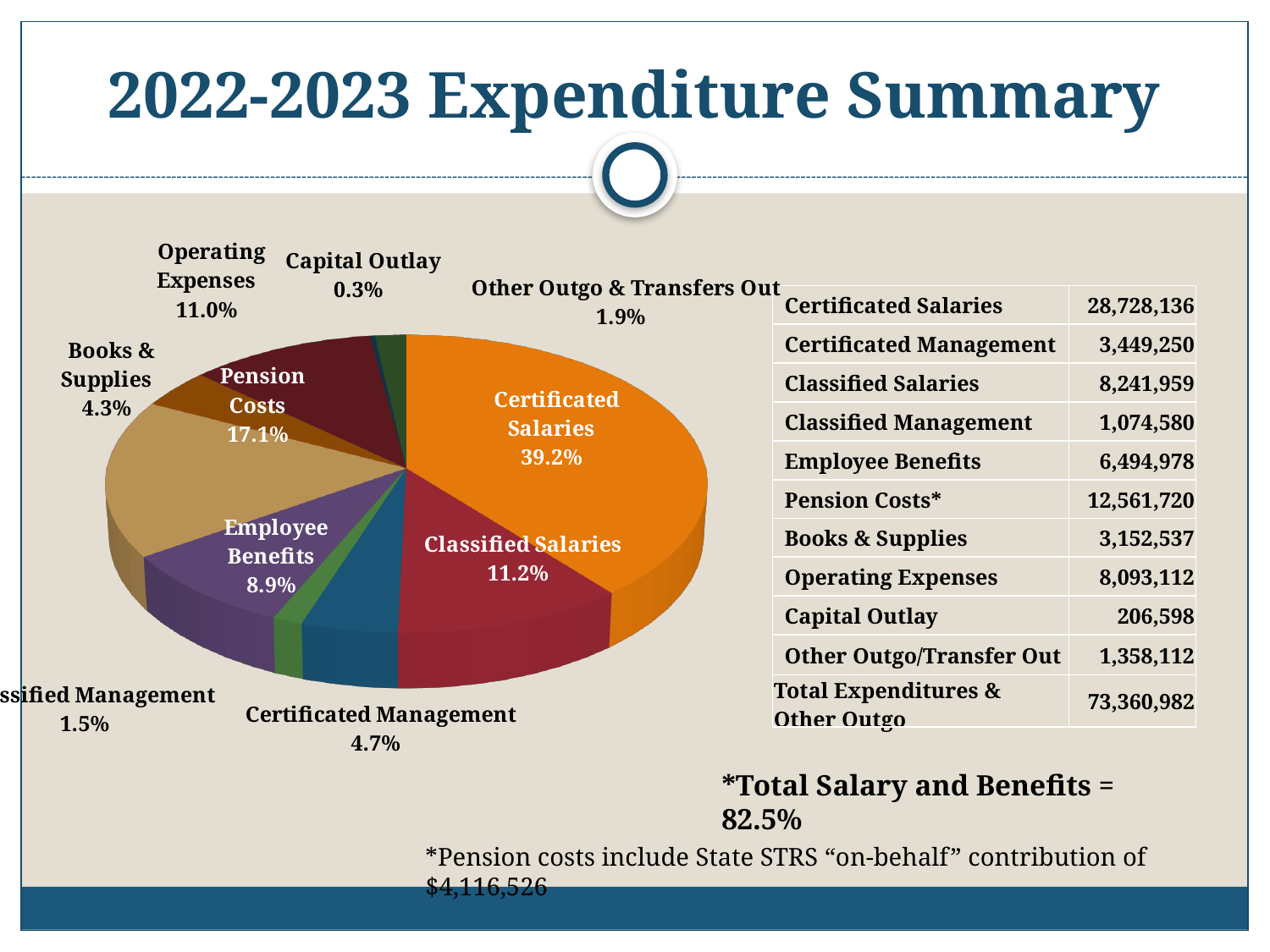
What percentage is shown for Employee Benefits in the pie chart? 8.9% What kind of chart is shown on the slide? pie chart How many percentage points larger is the Certificated Salaries share than the Pension Costs share? 22.1 percentage points Which slice is larger, Classified Salaries or Certificated Management? Classified Salaries Which category has the largest slice of the pie chart? Certificated Salaries Which category has the smallest slice of the pie chart? Capital Outlay What percentage is shown for Other Outgo & Transfers Out in the pie chart? 1.9% What percentage is shown for Operating Expenses in the pie chart? 11.0% What is the title of the slide containing the pie chart? 2022-2023 Expenditure Summary What share of expenditures does the Certificated Salaries slice represent? 39.2% What percentage is shown for Pension Costs in the pie chart? 17.1% How many slices does the pie chart have? 10